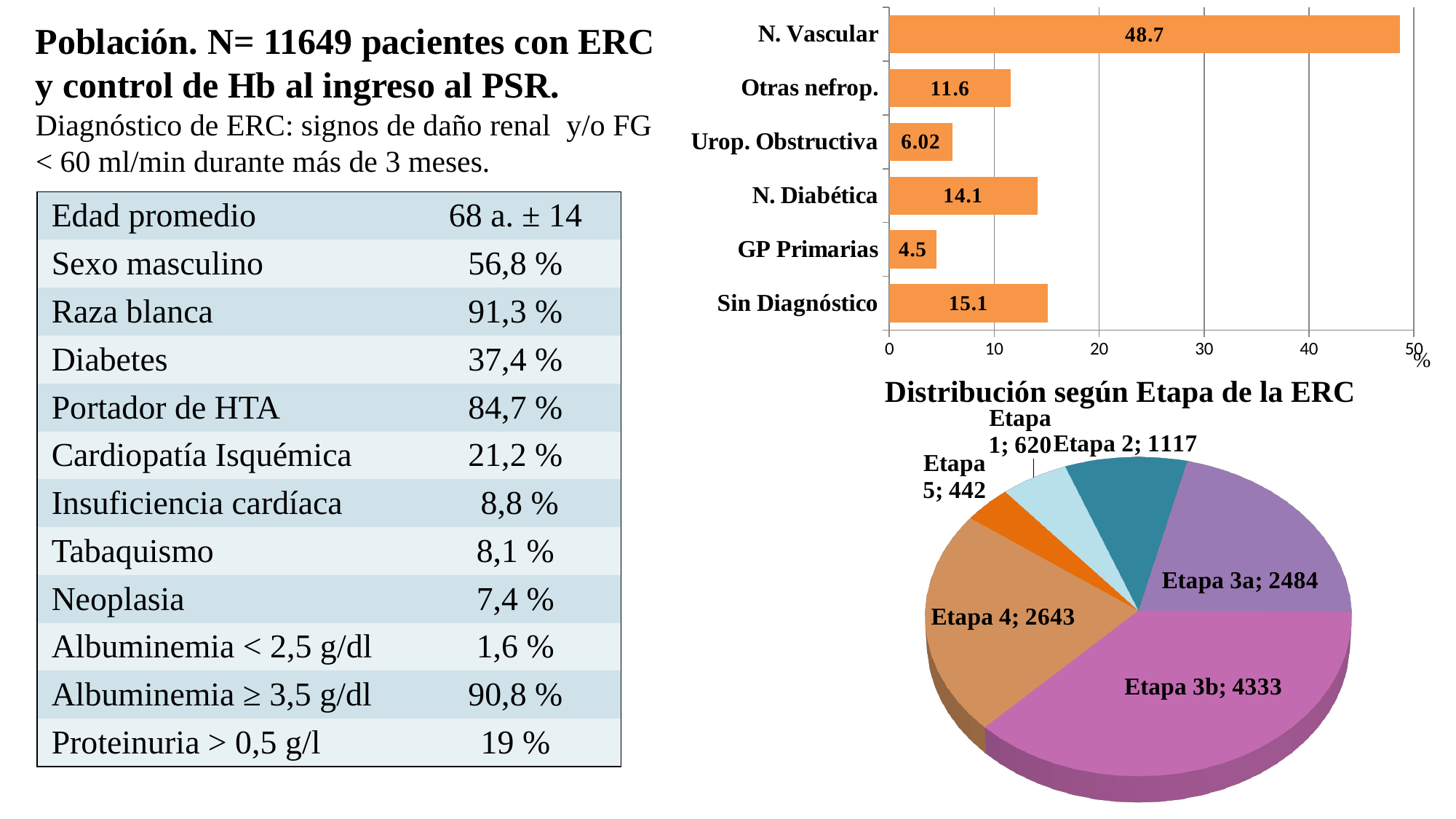
In the bar chart at the top right, what is the difference between the values for N. Vascular and Sin Diagnóstico? 33.6 In the chart 'Distribución según Etapa de la ERC', what is the value for Etapa 3b? 4333 In the bar chart at the top right, which category has the lowest value? GP Primarias In the bar chart at the top right, which is larger: N. Diabética or Otras nefrop.? N. Diabética How many categories does the bar chart at the top right show? 6 In the bar chart at the top right, which category has the highest value? N. Vascular What kind of chart is 'Distribución según Etapa de la ERC'? Pie chart In the bar chart at the top right, what is the value for N. Vascular? 48.7 In the bar chart at the top right, what is the value for Urop. Obstructiva? 6.02 In the chart 'Distribución según Etapa de la ERC', which stage has the smallest slice? Etapa 5 What kind of chart is the chart at the top right of the slide? Bar chart In the chart 'Distribución según Etapa de la ERC', what is the difference between the values for Etapa 3b and Etapa 4? 1690